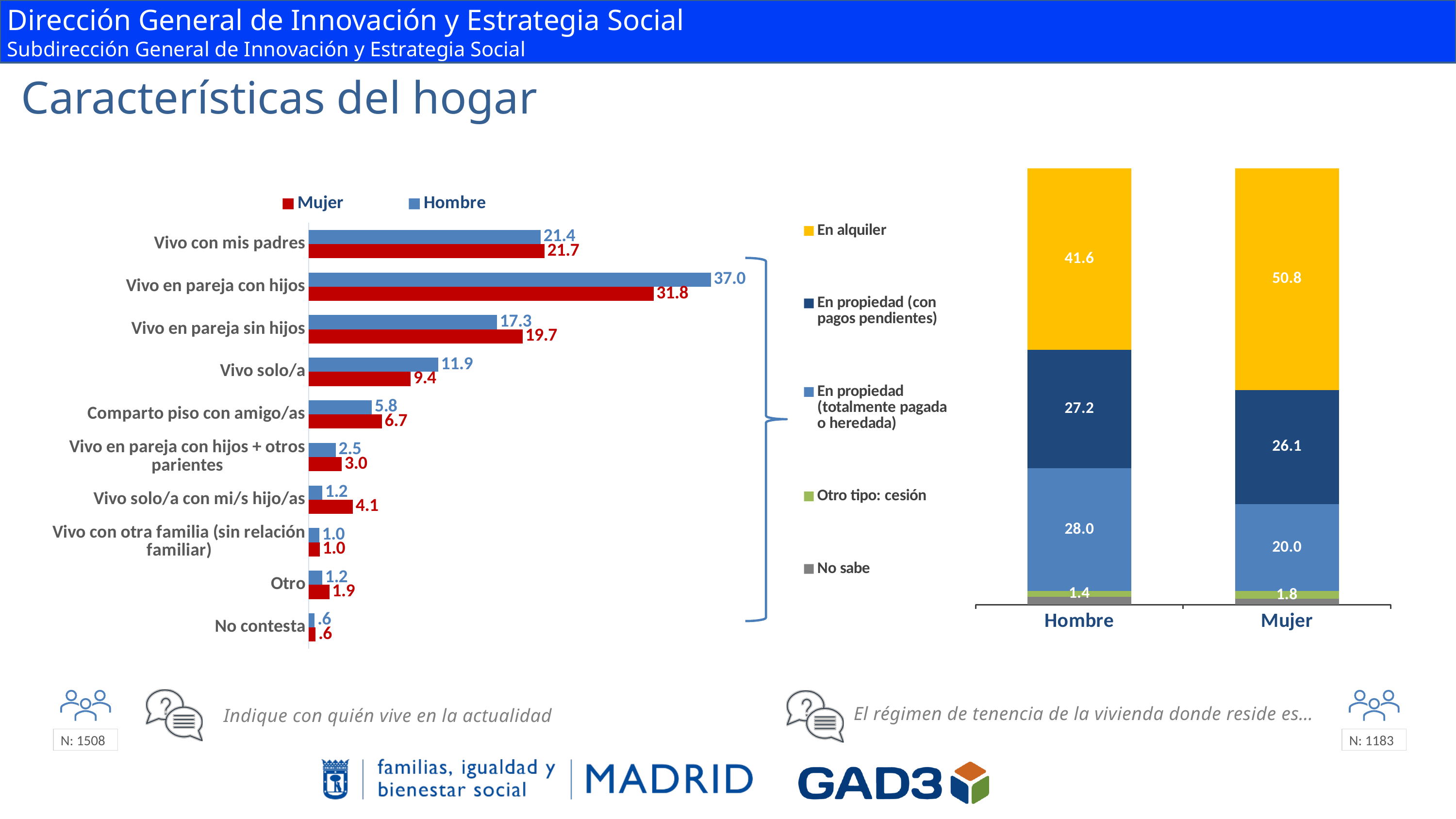
In the left chart (Indique con quién vive en la actualidad), how many categories are shown? 10 In the left chart (Indique con quién vive en la actualidad), what is the Hombre value for 'Vivo en pareja con hijos'? 37.0 In the left chart (Indique con quién vive en la actualidad), how many series does the legend list? 2 In the left chart (Indique con quién vive en la actualidad), which category has the lowest Hombre value? No contesta In the left chart (Indique con quién vive en la actualidad), what is the Mujer value for 'Vivo solo/a'? 9.4 In the left chart (Indique con quién vive en la actualidad), what is the difference between the Hombre and Mujer values for 'Vivo en pareja con hijos'? 5.2 In the left chart (Indique con quién vive en la actualidad), which category has the highest Mujer value? Vivo en pareja con hijos What kind of chart is the right chart (El régimen de tenencia de la vivienda donde reside es...)? Stacked bar chart In the left chart (Indique con quién vive en la actualidad), which is larger for 'Vivo en pareja sin hijos', the Mujer value or the Hombre value? Mujer In the right chart (El régimen de tenencia de la vivienda donde reside es...), what is the 'En alquiler' value for Mujer? 50.8 In the right chart (El régimen de tenencia de la vivienda donde reside es...), what is the difference between the 'En propiedad (totalmente pagada o heredada)' values for Hombre and Mujer? 8.0 In the right chart (El régimen de tenencia de la vivienda donde reside es...), how many series does the legend list? 5